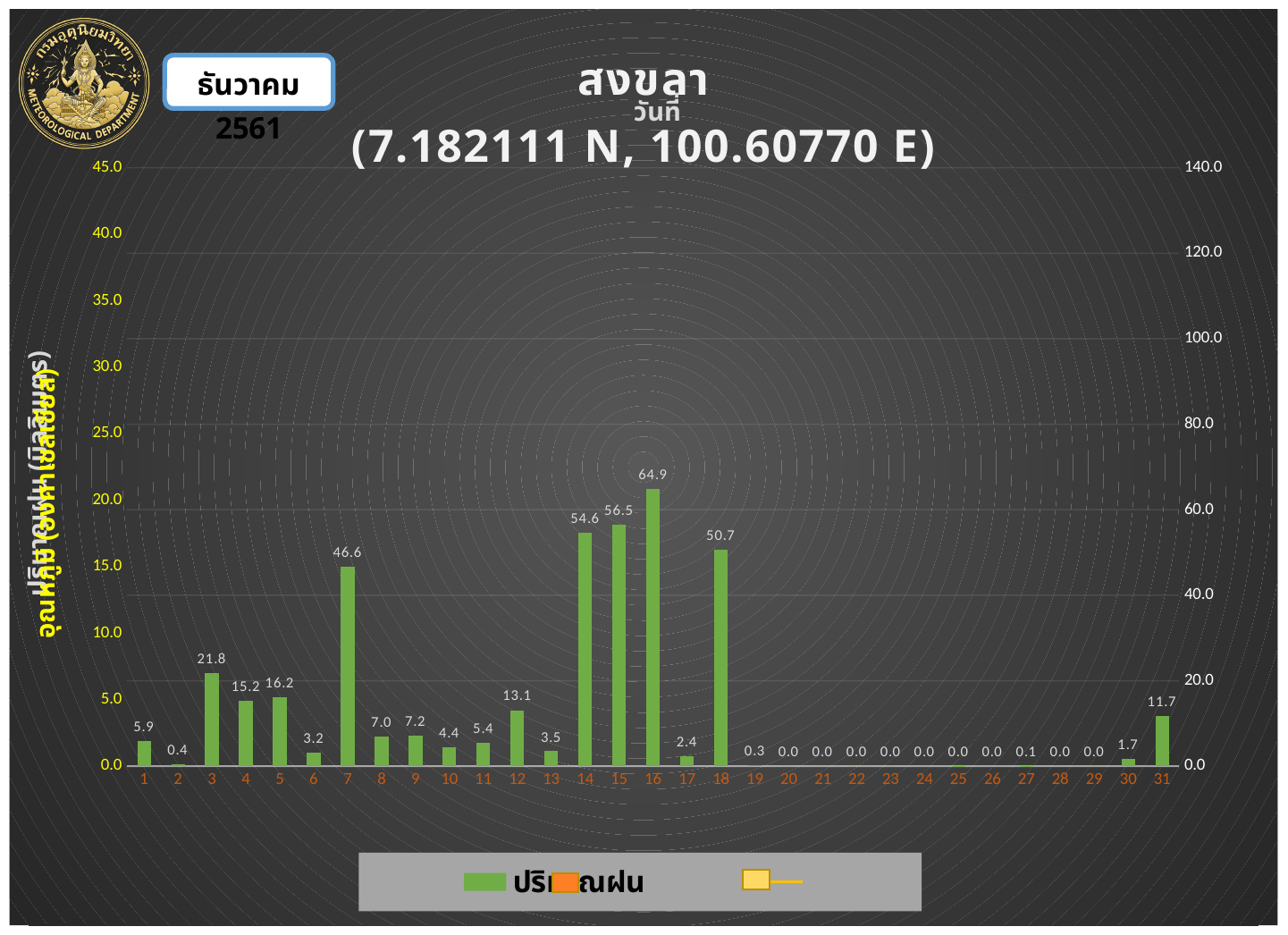
What kind of chart is shown on the slide? bar chart Which is larger, the rainfall value for day 4 or for day 5? day 5 What is the difference between the rainfall values for day 14 and day 18? 3.9 What is the rainfall value shown for day 31? 11.7 What is the rainfall value shown for day 7? 46.6 What is the rainfall value shown for day 3? 21.8 How many days (categories) are shown on the x axis? 31 What is the rainfall value shown for day 27? 0.1 What is the rainfall value shown for day 16? 64.9 Which day has the highest rainfall value? 16 What is the difference between the rainfall values for day 16 and day 15? 8.4 Which is larger, the rainfall value for day 12 or for day 13? day 12